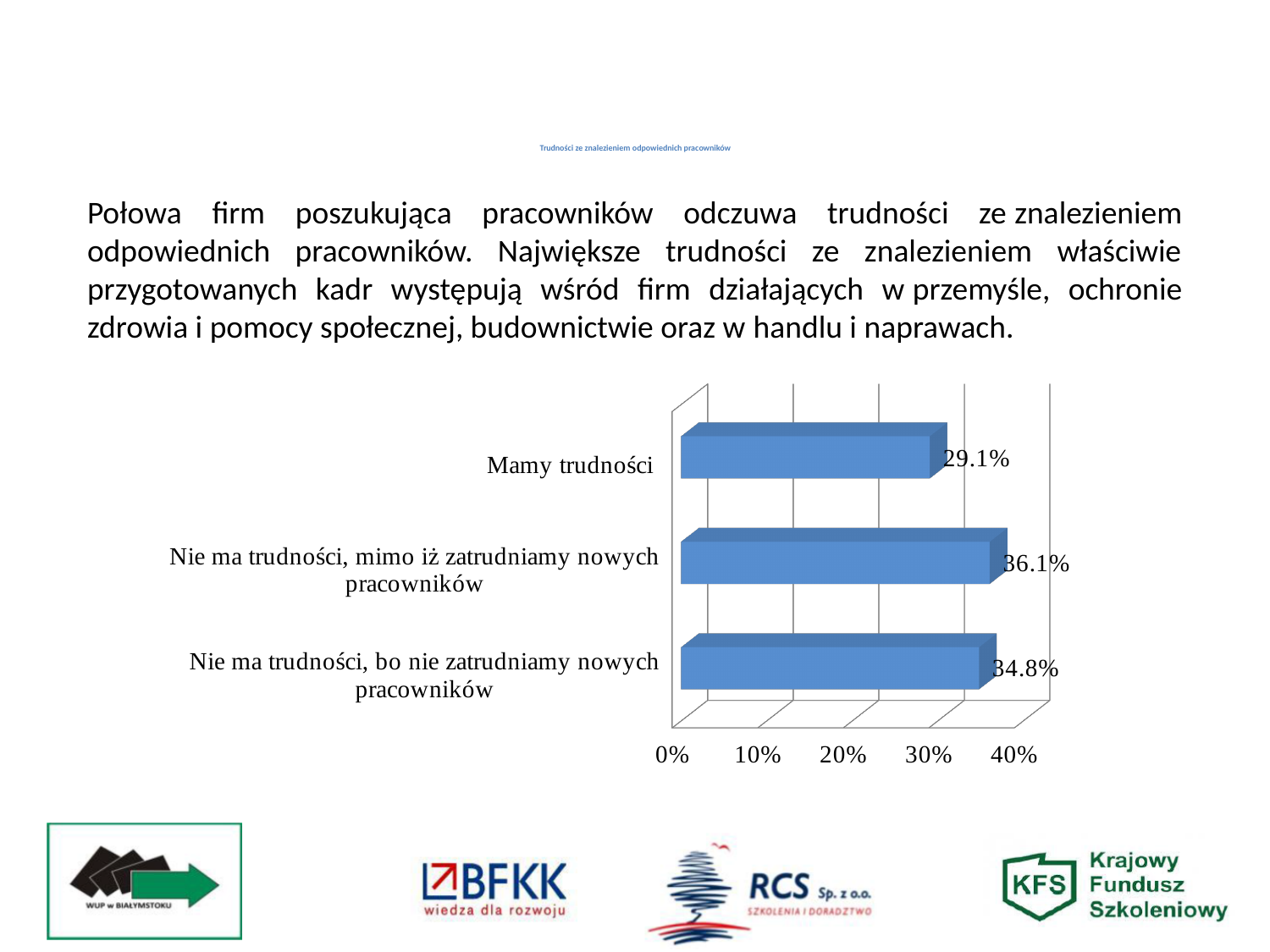
Is the value for "Mamy trudności" greater or less than 30%? less What colour are the bars in the chart? blue What is the difference between the values for "Nie ma trudności, mimo iż zatrudniamy nowych pracowników" and "Mamy trudności"? 7.0 percentage points What is the value for "Nie ma trudności, mimo iż zatrudniamy nowych pracowników"? 36.1% What is the value for "Nie ma trudności, bo nie zatrudniamy nowych pracowników"? 34.8% Which is larger: the value for "Mamy trudności" or for "Nie ma trudności, bo nie zatrudniamy nowych pracowników"? Nie ma trudności, bo nie zatrudniamy nowych pracowników Which category has the lowest value? Mamy trudności How many categories are shown in the chart? 3 What is the value for "Mamy trudności"? 29.1% What is the difference between the values for "Nie ma trudności, mimo iż zatrudniamy nowych pracowników" and "Nie ma trudności, bo nie zatrudniamy nowych pracowników"? 1.3 percentage points What kind of chart is shown on the slide? bar chart Which category has the highest value? Nie ma trudności, mimo iż zatrudniamy nowych pracowników